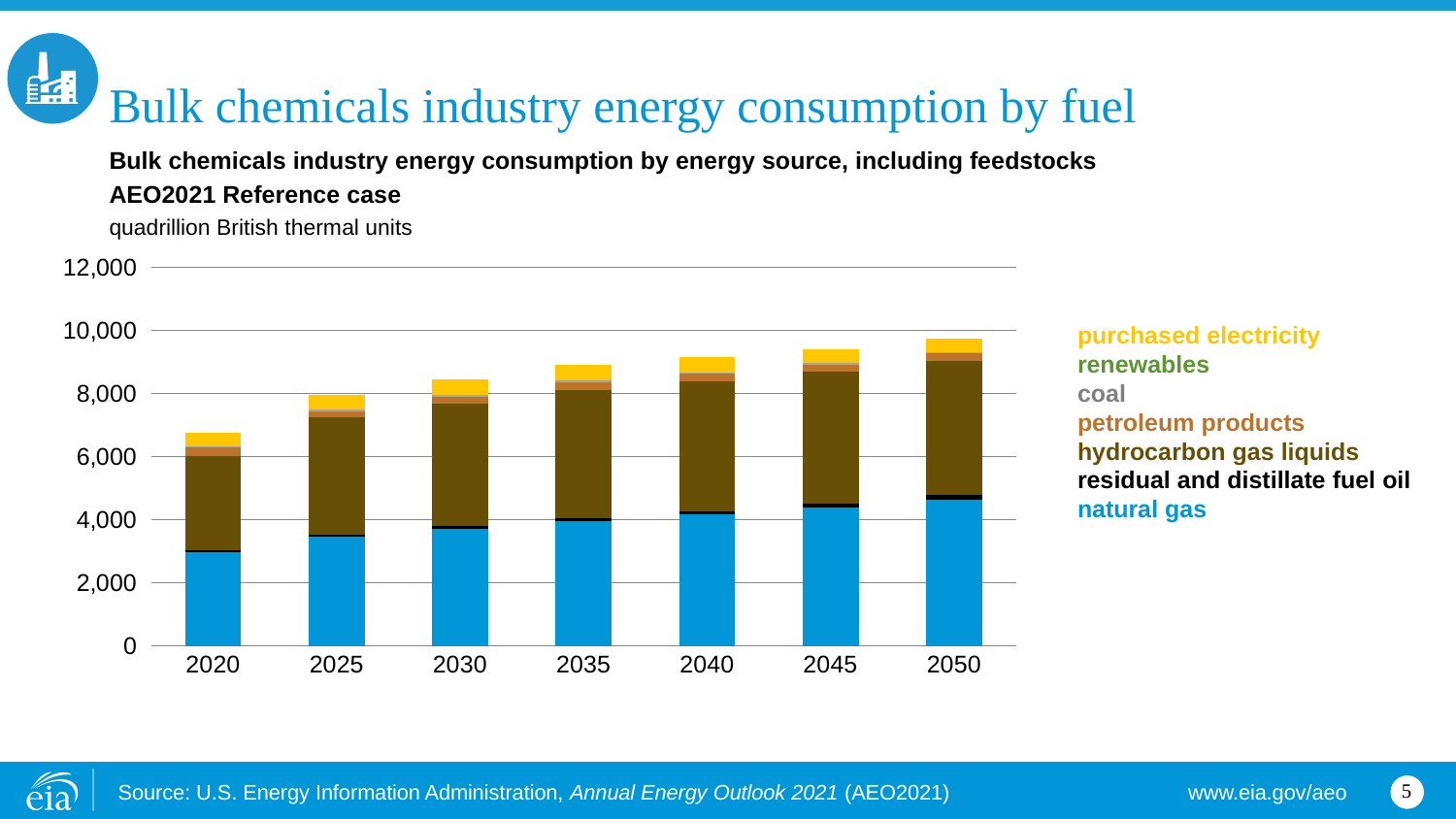
Which year has the highest total energy consumption? 2050 Is the total energy consumption for 2050 greater or less than 10,000? less What kind of chart is shown on the slide? stacked bar chart Is the total energy consumption for 2020 greater or less than 8,000? less Which year has the lowest total energy consumption? 2020 Is the natural gas value for 2020 greater or less than 4,000? less How many years are shown along the x axis of the chart? 7 How many energy sources does the legend list? 7 What unit is the chart's y axis measured in? quadrillion British thermal units Which is larger, the total energy consumption in 2020 or in 2050? 2050 Do total bulk chemicals energy consumption values rise or fall from 2020 to 2050? rise